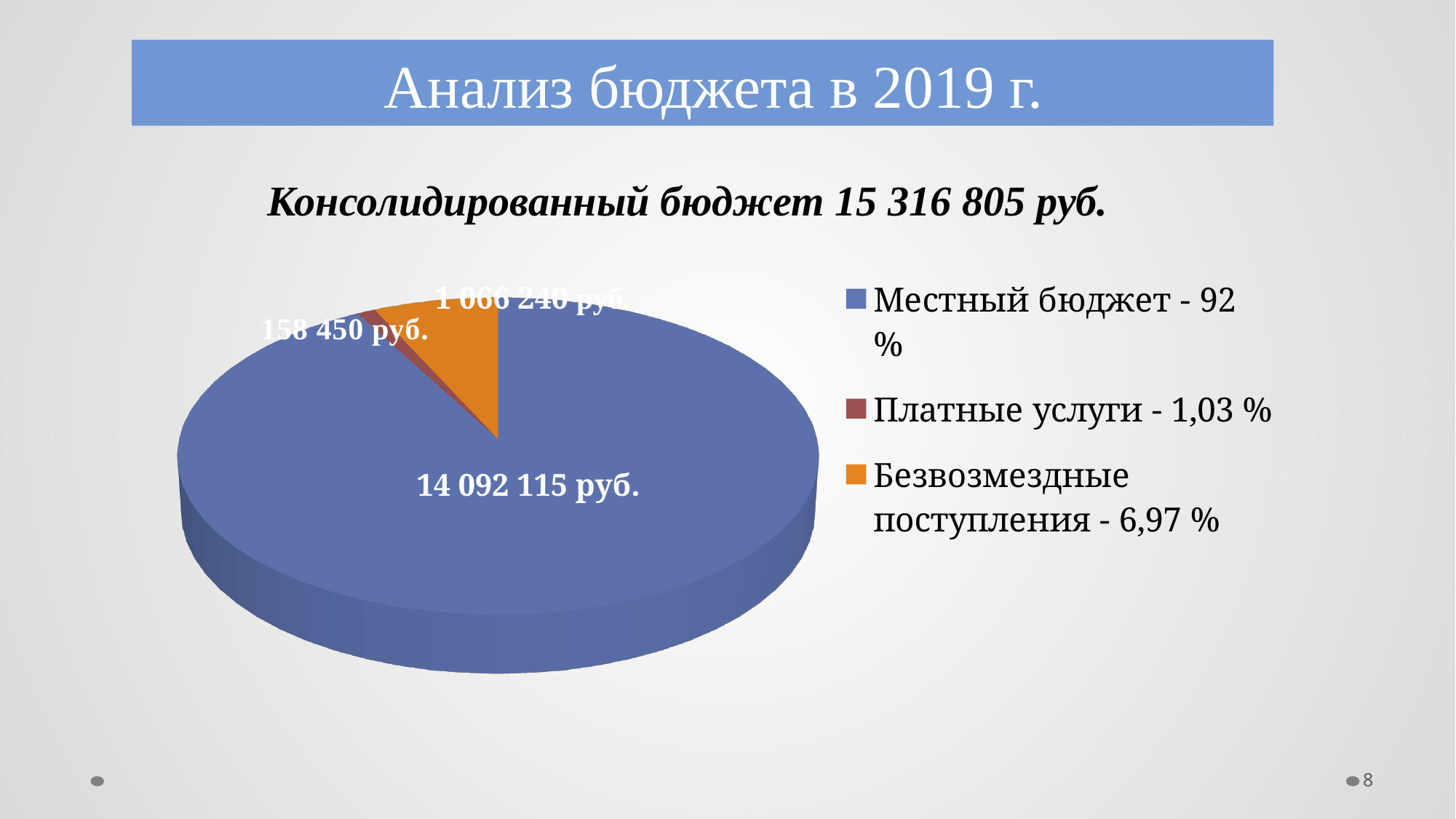
What value is labelled on the slice for Безвозмездные поступления? 1 066 240 руб. What share of the pie does Платные услуги represent, according to the legend? 1,03 % What value is labelled on the slice for Местный бюджет? 14 092 115 руб. How many entries does the legend of the pie chart list? 3 Which category has the largest slice of the pie? Местный бюджет What is the difference between the value for Безвозмездные поступления and the value for Платные услуги? 907 790 руб. Which category has the smallest slice of the pie? Платные услуги How many slices does the pie chart have? 3 What type of chart is shown on the slide? Pie chart What share of the pie does Безвозмездные поступления represent, according to the legend? 6,97 % What value is labelled on the slice for Платные услуги? 158 450 руб. Which is larger: the value for Безвозмездные поступления or the value for Платные услуги? Безвозмездные поступления